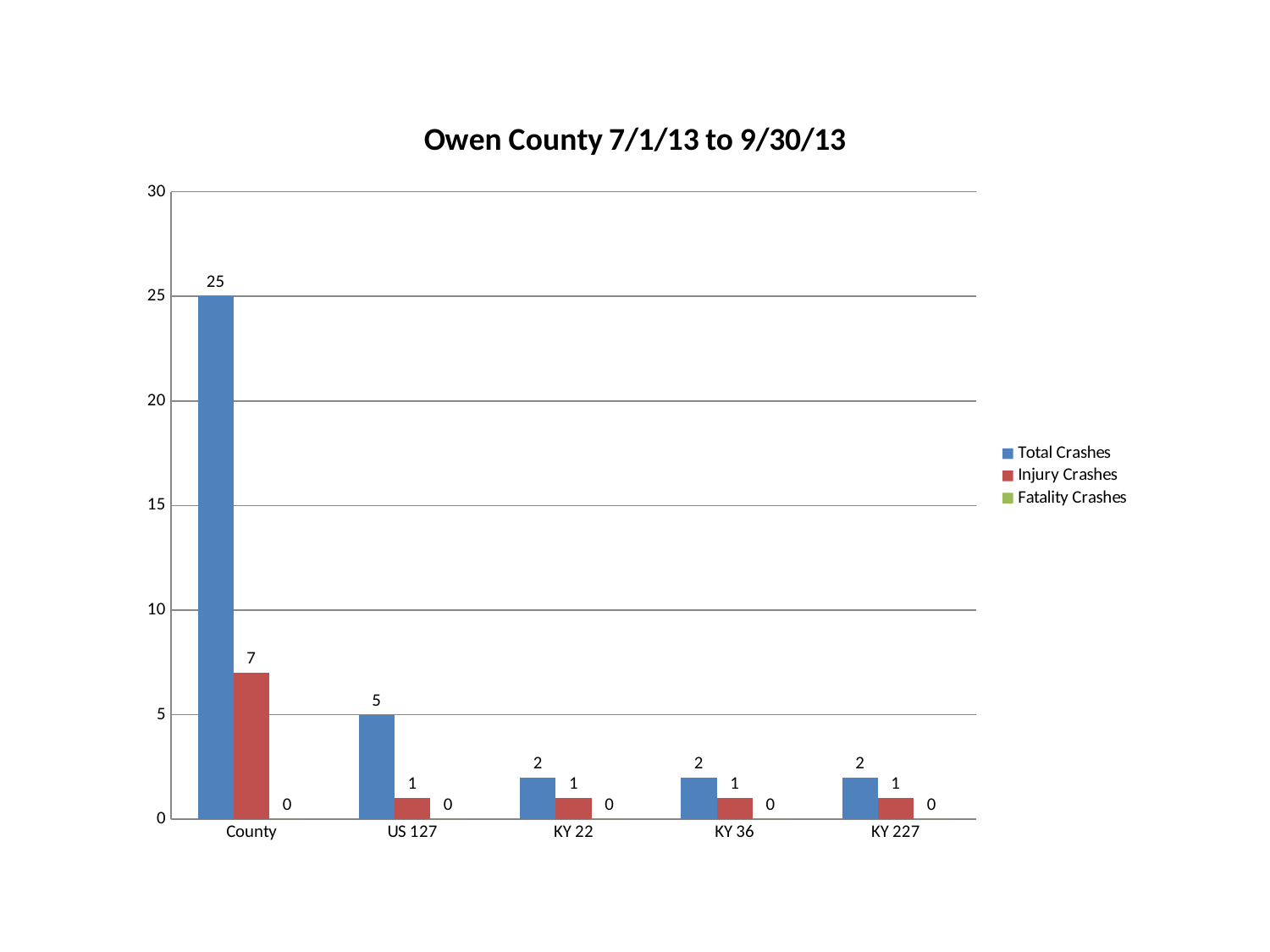
Which is larger, Total Crashes for US 127 or Total Crashes for KY 36? US 127 What is the value of Total Crashes for County? 25 What is the title of the chart? Owen County 7/1/13 to 9/30/13 What kind of chart is shown on the slide? Bar chart Which category has the highest Total Crashes? County What is the value of Fatality Crashes for KY 22? 0 Which category has the highest Injury Crashes? County What is the difference in Total Crashes between County and US 127? 20 What is the value of Injury Crashes for US 127? 1 What is the difference between Total Crashes and Injury Crashes for County? 18 How many categories are shown on the x axis? 5 How many series does the legend list? 3